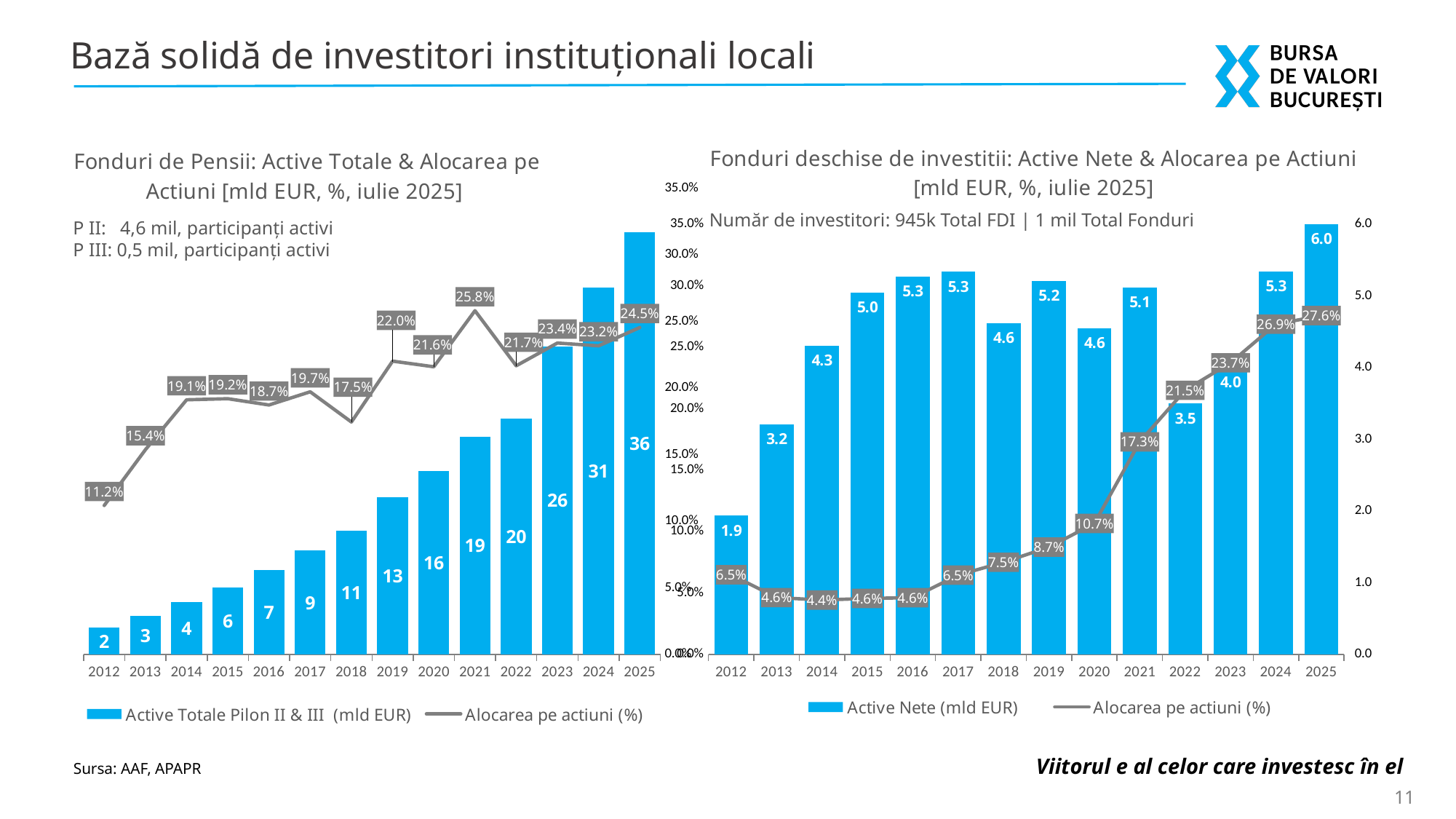
In the right chart (Fonduri deschise de investitii), which year has the lowest Active Nete value? 2012 In the right chart (Fonduri deschise de investitii), which is larger, the Active Nete value for 2022 or for 2023? 2023 In the right chart (Fonduri deschise de investitii), how many series does the legend list? 2 What kind of chart is the right chart (Fonduri deschise de investitii)? Combined bar and line chart In the left chart (Fonduri de Pensii), what is the Alocarea pe actiuni (%) value for 2021? 25.8% In the left chart (Fonduri de Pensii), what is the difference between the Active Totale values for 2025 and 2024? 5 In the left chart (Fonduri de Pensii), which year has the highest Alocarea pe actiuni (%)? 2021 In the right chart (Fonduri deschise de investitii), what is the Active Nete value for 2025? 6.0 In the right chart (Fonduri deschise de investitii), what is the Alocarea pe actiuni (%) value for 2020? 10.7% In the left chart (Fonduri de Pensii), how many years are shown on the x axis? 14 In the left chart (Fonduri de Pensii), do the Active Totale bar values rise or fall from 2012 to 2025? rise In the left chart (Fonduri de Pensii), what is the value of Active Totale Pilon II & III for 2025? 36